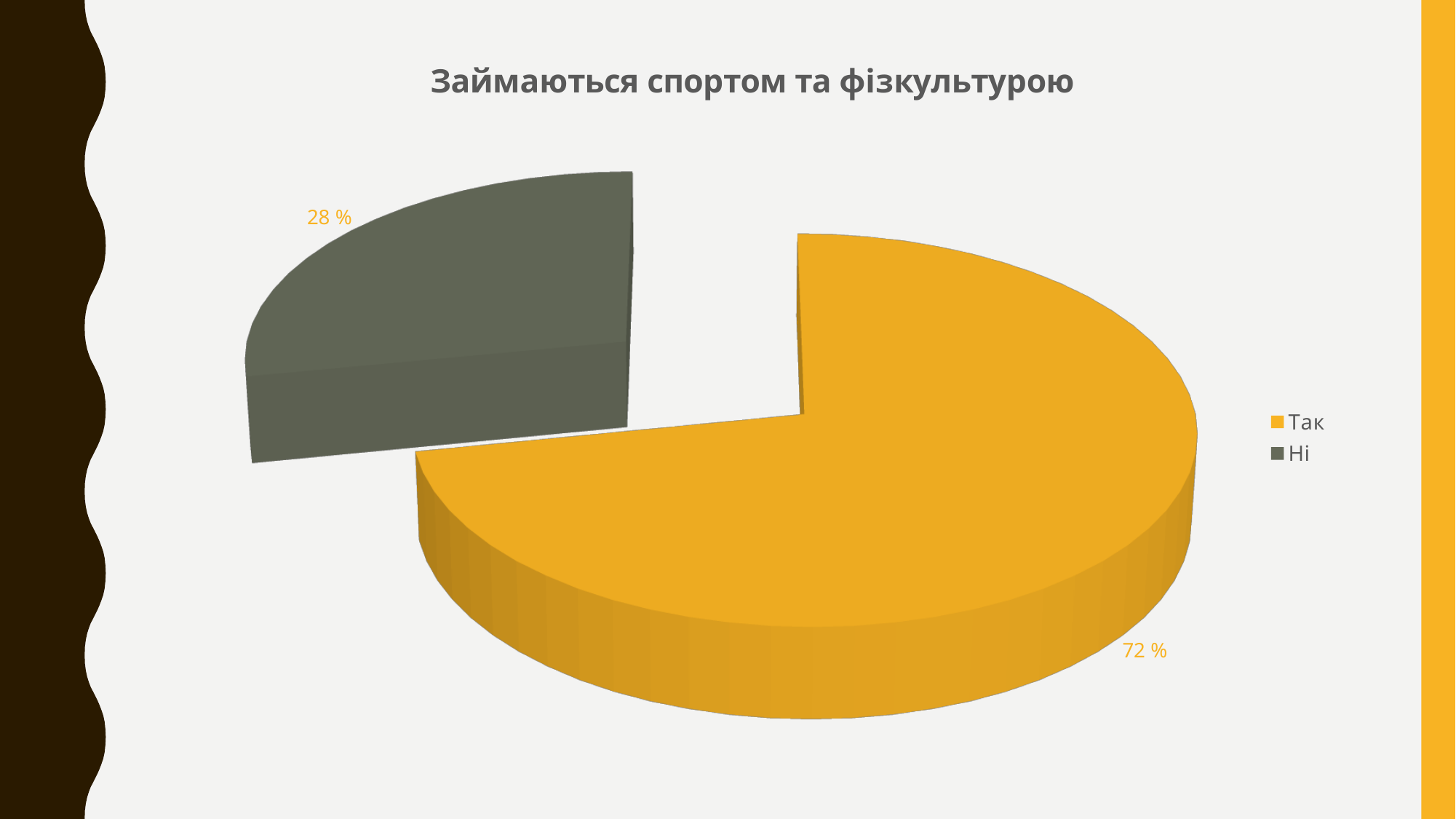
What is the title of the chart? Займаються спортом та фізкультурою Which category has the largest slice of the pie? Так What share of the pie does the 'Так' slice represent? 72 % What colour is the 'Ні' slice? grey What share of the pie does the 'Ні' slice represent? 28 % Which is larger, the 'Так' slice or the 'Ні' slice? Так Which category has the smallest slice of the pie? Ні How many entries does the legend list? 2 How many categories does the pie chart have? 2 What type of chart is shown on the slide? pie chart What is the difference between the 'Так' and 'Ні' shares? 44 %